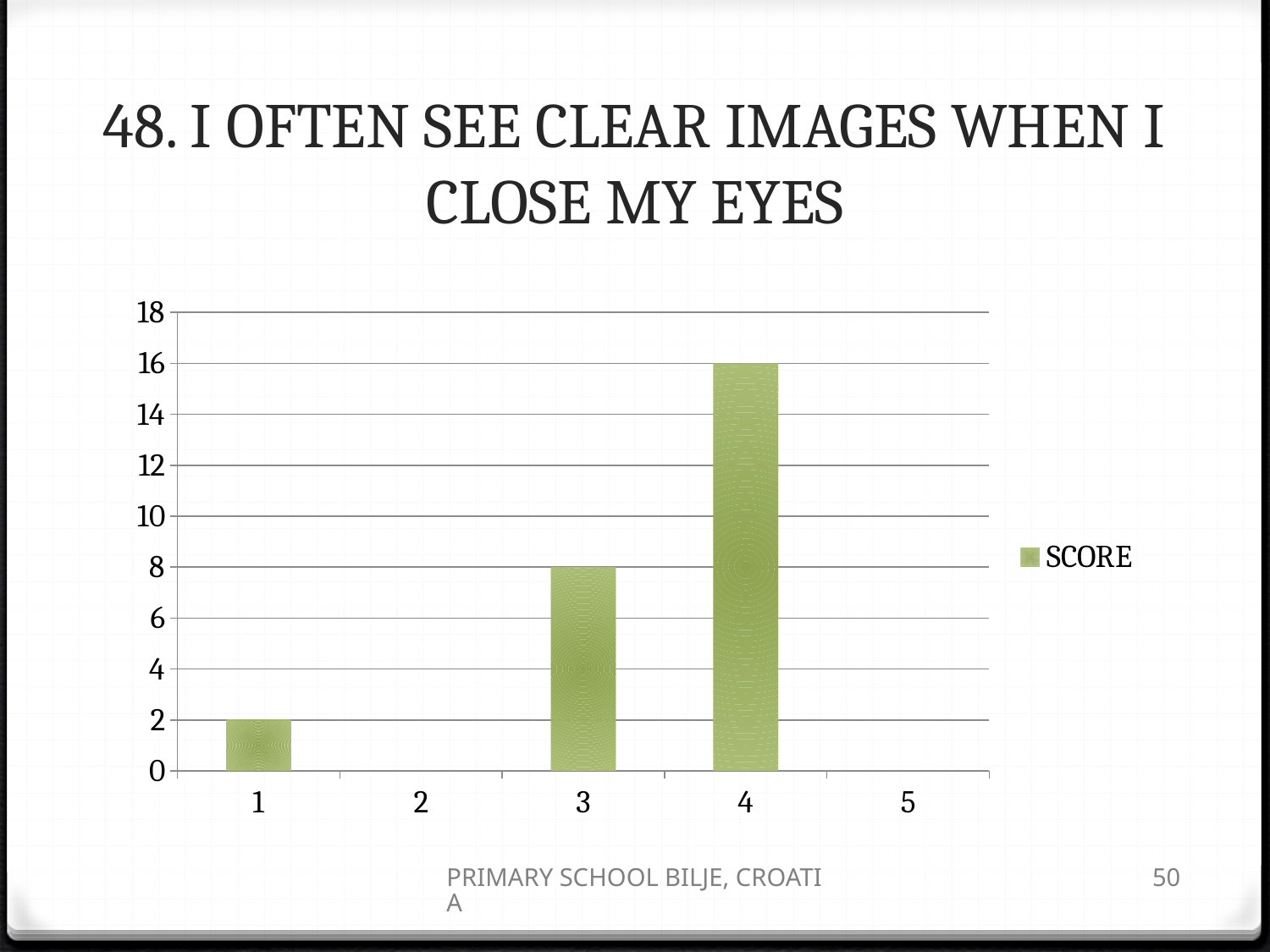
Which category has the highest value? 4 Which is larger, the value for category 3 or the value for category 1? category 3 What is the value for category 3? 8 How many series does the legend list? 1 What is the highest value shown on the y axis? 18 What is the name of the series shown in the legend? SCORE How many categories are shown on the x axis? 5 What is the value for category 1? 2 Is the value for category 4 greater or less than 10? greater What type of chart is shown on the slide? bar chart What is the value for category 4? 16 What is the difference between the values for category 4 and category 3? 8